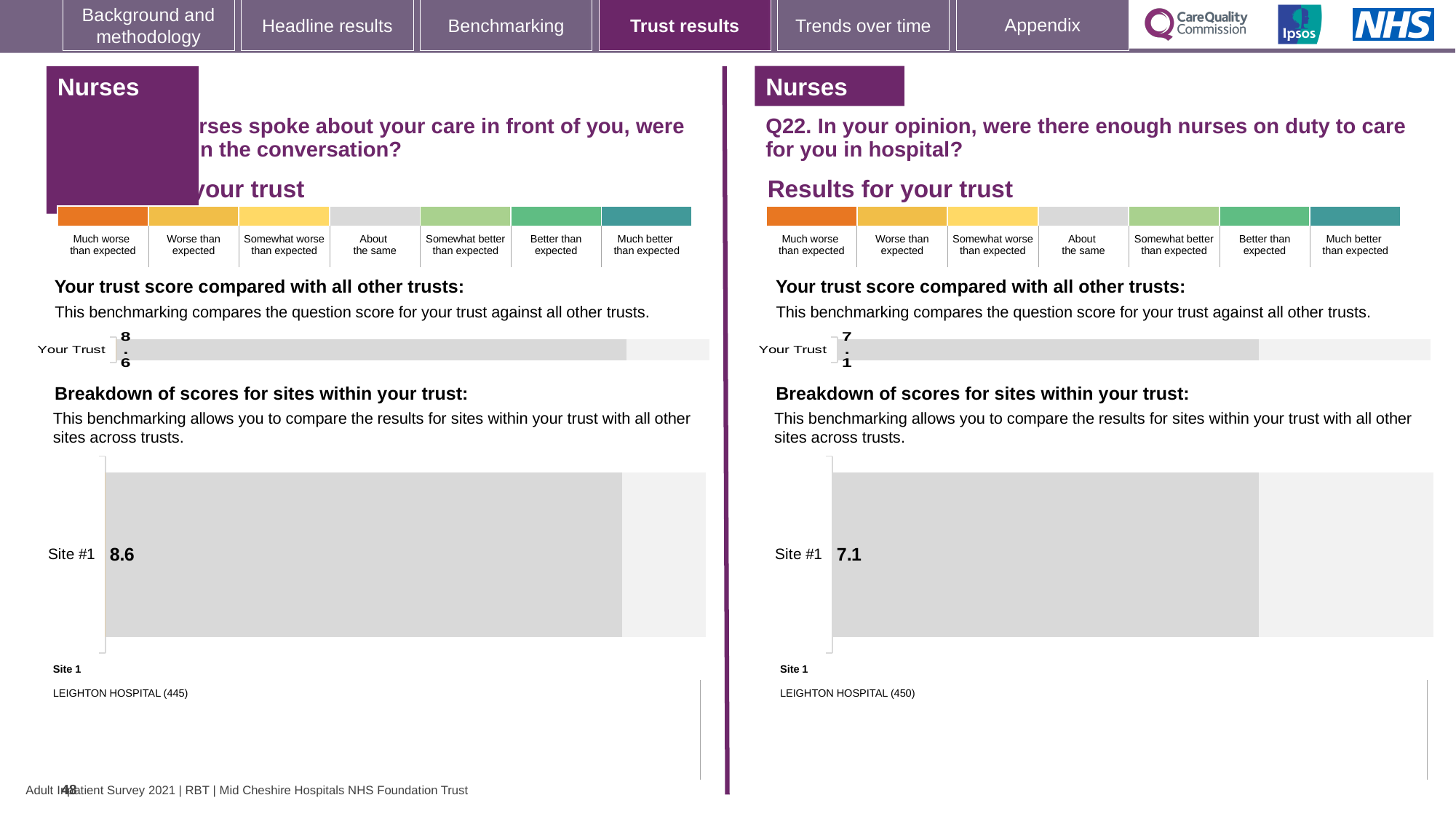
What kind of chart is used to show the Site #1 score on the right half of the slide? Bar chart Which Site #1 score is larger: the one on the left half of the slide or the one on the right half (Q22)? Left half (8.6) On the right half of the slide (Q22), which site is listed as Site 1 below the chart? LEIGHTON HOSPITAL (450) On the right half of the slide (Q22), what is the score shown for Site #1? 7.1 On the left half of the slide, what is the score shown for Site #1? 8.6 What is the difference between the Site #1 score on the left half of the slide and the Site #1 score on the right half (Q22)? 1.5 On the left half of the slide, which site is listed as Site 1 below the chart? LEIGHTON HOSPITAL (445) How many sites are shown in the site breakdown chart on the left half of the slide? 1 On the right half of the slide (Q22), what is the score shown for Your Trust in the trust comparison chart? 7.1 How many sites are shown in the site breakdown chart on the right half of the slide (Q22)? 1 On the left half of the slide, what is the score shown for Your Trust in the trust comparison chart? 8.6